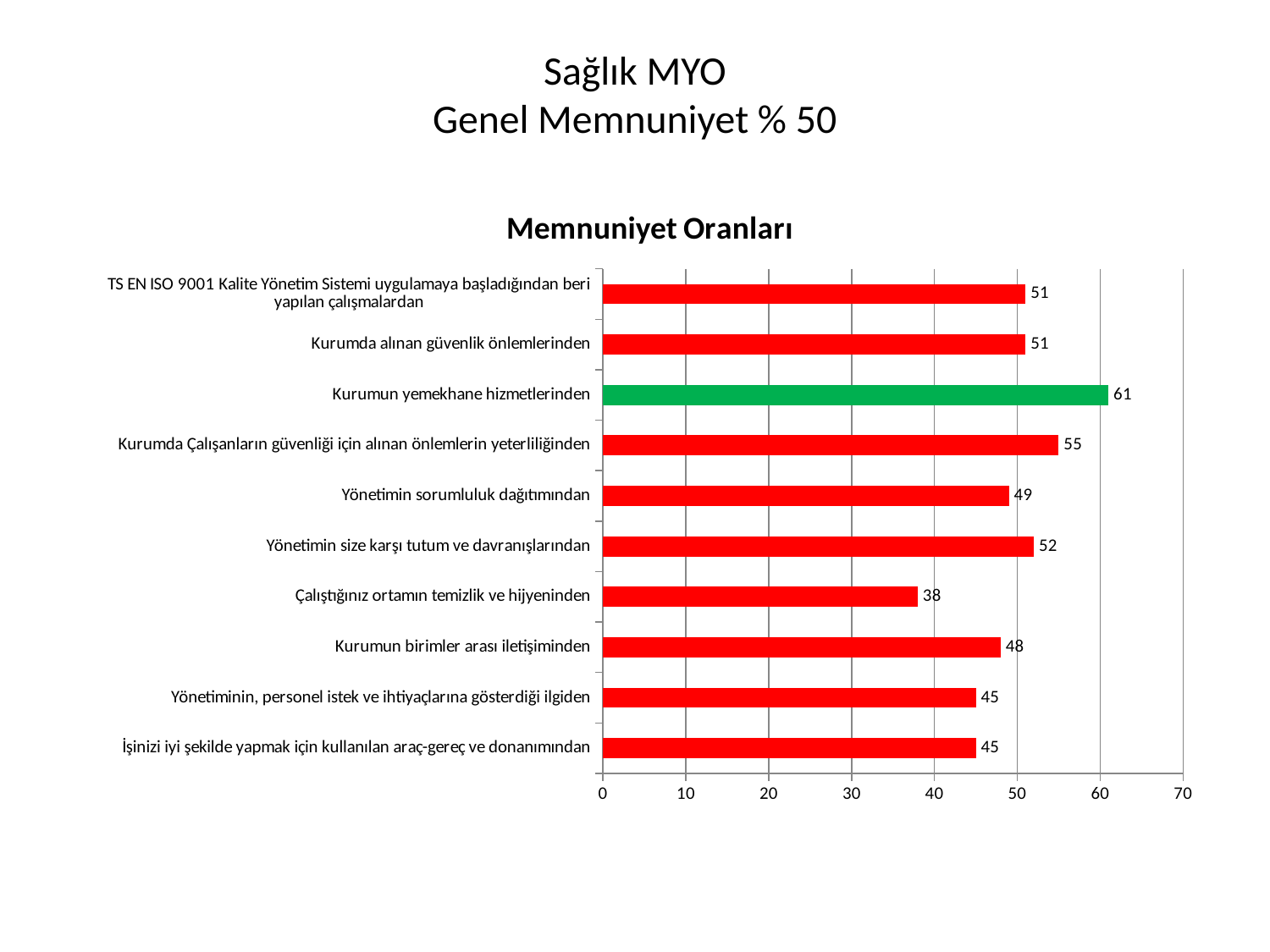
What is the difference between the values for "Kurumda Çalışanların güvenliği için alınan önlemlerin yeterliliğinden" and "Kurumun birimler arası iletişiminden"? 7 Is the value for "Kurumda alınan güvenlik önlemlerinden" greater or less than 40? greater Which is larger: the value for "Yönetimin size karşı tutum ve davranışlarından" or the value for "Yönetiminin, personel istek ve ihtiyaçlarına gösterdiği ilgiden"? Yönetimin size karşı tutum ve davranışlarından What is the value for "Yönetimin sorumluluk dağıtımından"? 49 What is the title of the chart? Memnuniyet Oranları Which category has the highest value? Kurumun yemekhane hizmetlerinden Which category has the lowest value? Çalıştığınız ortamın temizlik ve hijyeninden What kind of chart is shown on the slide? bar chart What is the value for "Kurumun yemekhane hizmetlerinden"? 61 What is the difference between the values for "Kurumun yemekhane hizmetlerinden" and "Çalıştığınız ortamın temizlik ve hijyeninden"? 23 How many categories are shown in the chart? 10 What is the value for "Çalıştığınız ortamın temizlik ve hijyeninden"? 38